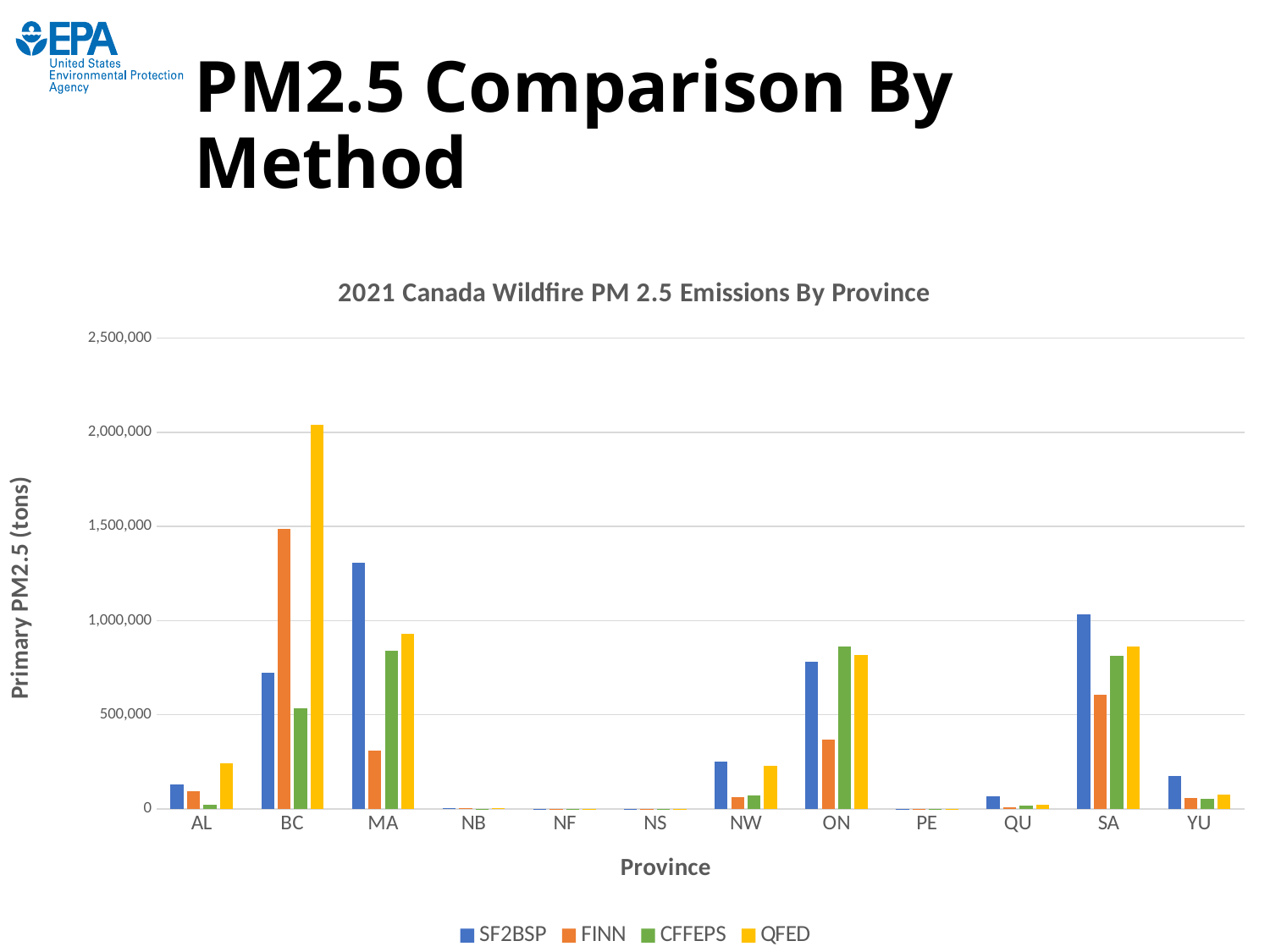
Is the QFED value for BC greater or less than 1,500,000? greater What kind of chart is shown on the slide? bar chart For MA, which is larger: the SF2BSP value or the FINN value? SF2BSP Which province has the tallest bar in the chart? BC How many series does the legend list? 4 Is the SF2BSP value for MA greater or less than 1,000,000? greater Is the SF2BSP value for SA greater or less than 500,000? greater How many provinces are shown on the x axis? 12 What is the title of the chart? 2021 Canada Wildfire PM 2.5 Emissions By Province Which province has the highest SF2BSP value? MA For BC, which is larger: the FINN value or the CFFEPS value? FINN